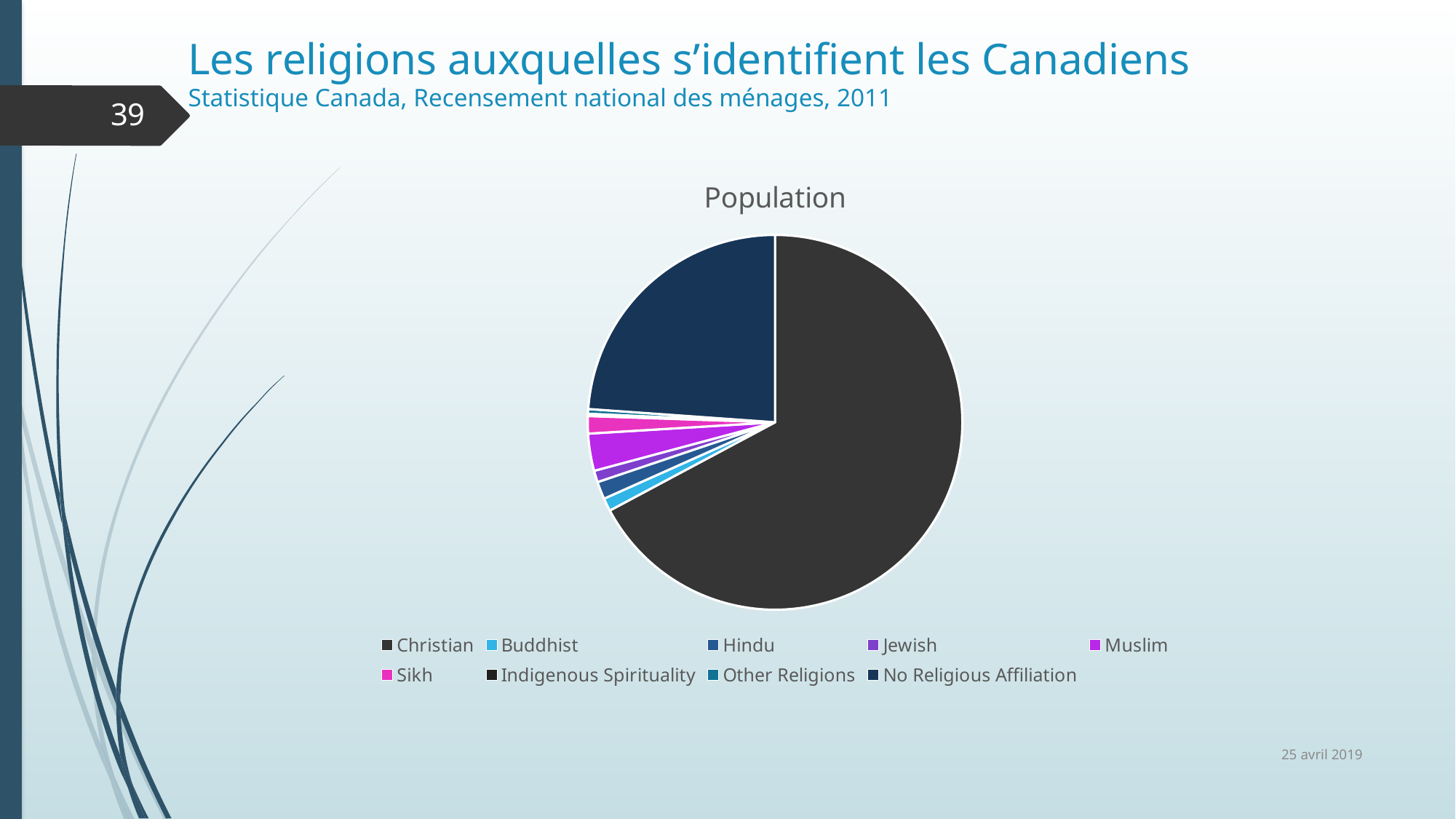
What kind of chart is shown on the slide? pie chart Which slice is larger, Muslim or Hindu? Muslim Which slice is larger, No Religious Affiliation or Muslim? No Religious Affiliation Which slice is larger, Christian or No Religious Affiliation? Christian How many categories does the chart's legend list? 9 Which category has the second-largest slice of the pie? No Religious Affiliation Which category has the largest slice of the pie? Christian What is the title of the chart? Population What colour is the Christian slice in the pie chart? dark grey